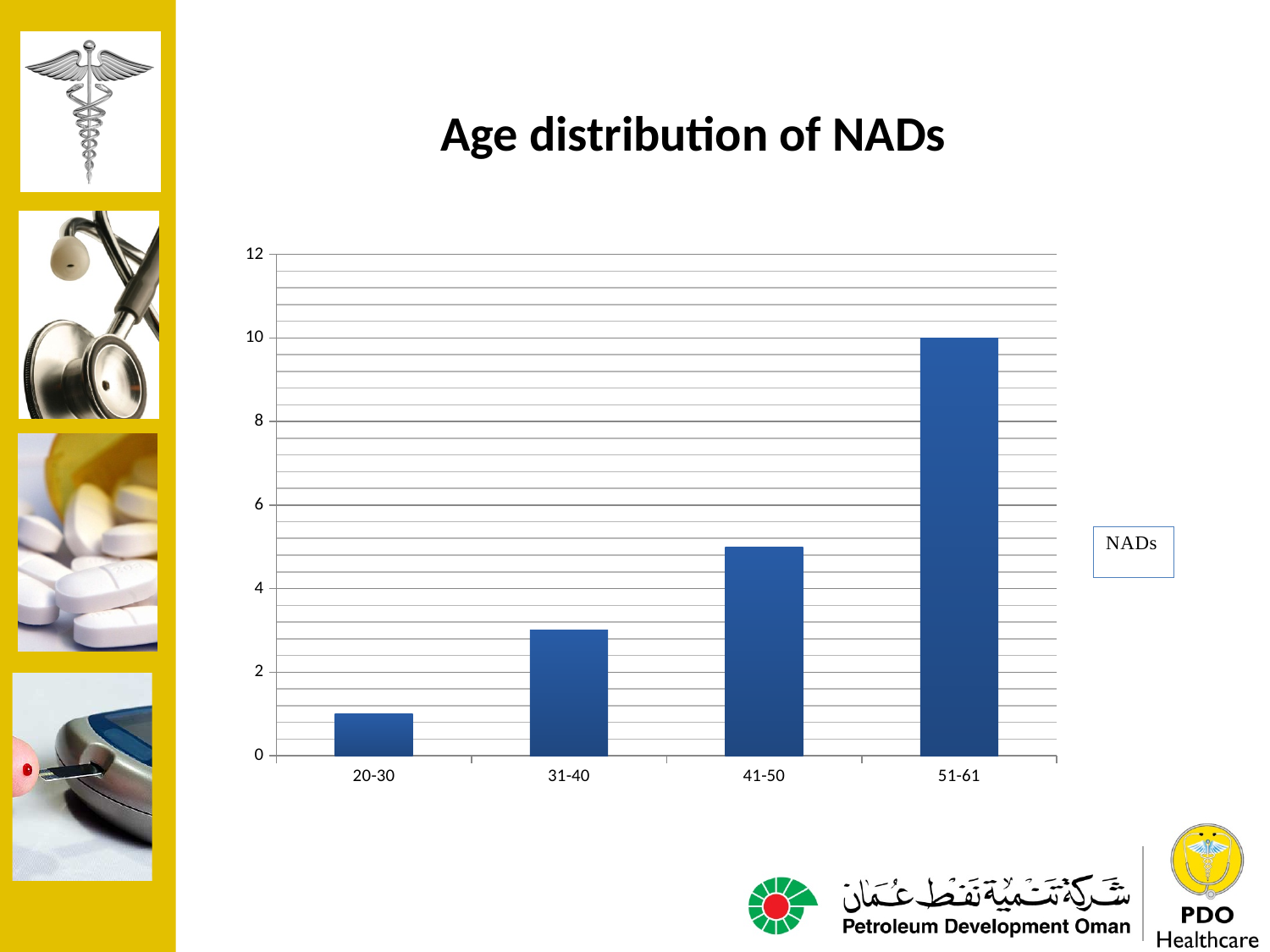
Which age group has the highest number of NADs? 51-61 Is the value for the 41-50 age group greater or less than 4? greater Do the values rise or fall from the 20-30 group to the 51-61 group? rise Which age group has the lowest number of NADs? 20-30 What type of chart is shown on the slide? bar chart What is the title of the chart? Age distribution of NADs Is the value for the 31-40 age group greater or less than 4? less Is the value for the 20-30 age group greater or less than 2? less How many age groups are shown on the x axis? 4 What is the value for the 51-61 age group? 10 How many series does the legend list? 1 Which is larger, the value for 31-40 or the value for 41-50? 41-50